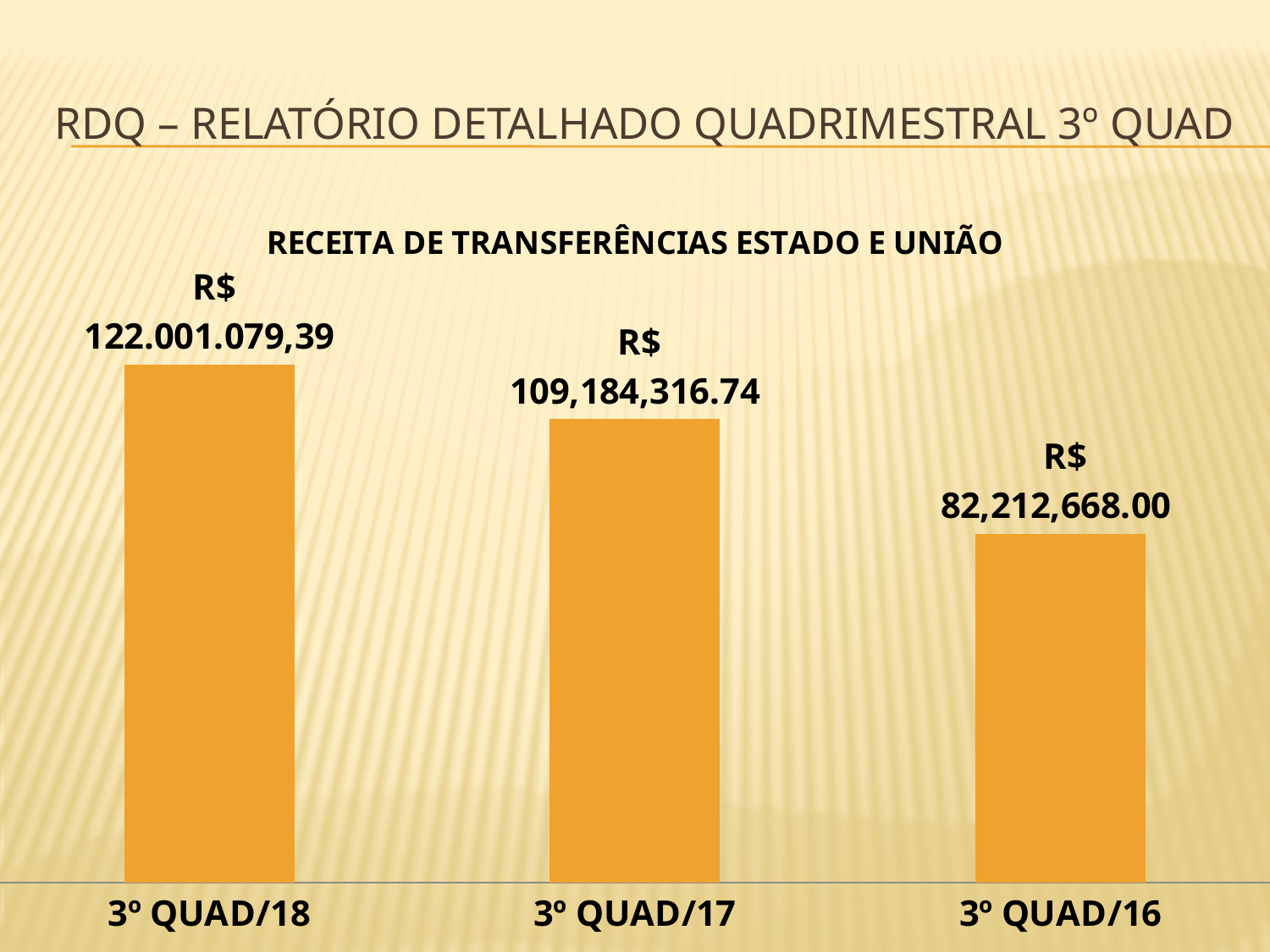
Which category has the highest value? 3º QUAD/18 Which category has the lowest value? 3º QUAD/16 What kind of chart is shown on the slide? Bar chart What is the title of the chart? RECEITA DE TRANSFERÊNCIAS ESTADO E UNIÃO What is the value for 3º QUAD/17? R$ 109,184,316.74 What is the value for 3º QUAD/16? R$ 82,212,668.00 What is the value for 3º QUAD/18? R$ 122.001.079,39 Which is larger, the value for 3º QUAD/17 or the value for 3º QUAD/16? 3º QUAD/17 What colour are the bars in the chart? Orange What is the difference between the values for 3º QUAD/17 and 3º QUAD/16? R$ 26,971,648.74 Do the values rise or fall from left to right along the x axis? Fall How many categories are shown in the chart? 3